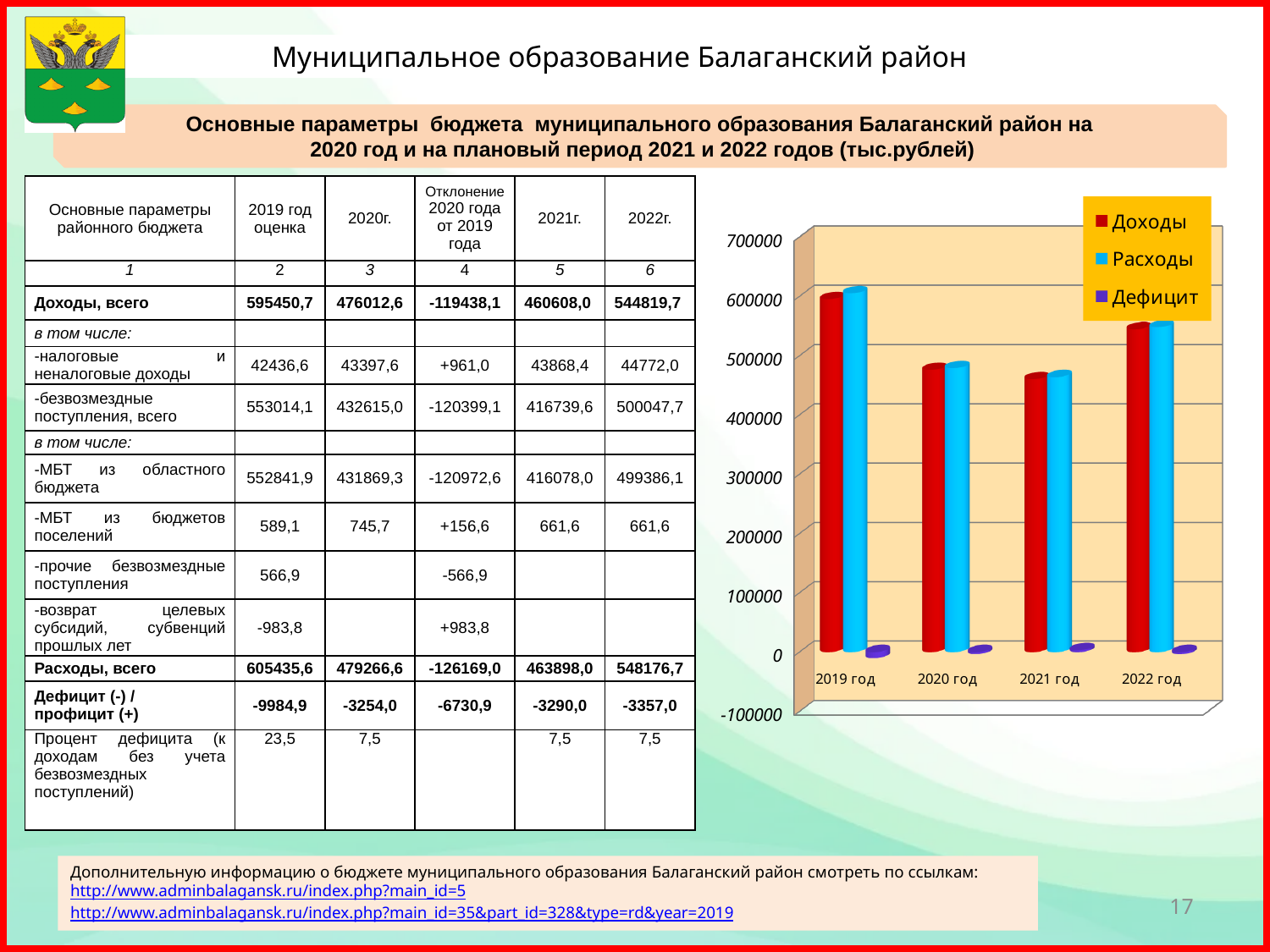
Which is larger in the chart: Доходы for 2020 год or Доходы for 2022 год? 2022 год Is the Расходы value for 2020 год greater or less than 600000? less Which year has the highest Доходы bar in the chart? 2019 год Is the Доходы value for 2021 год greater or less than 500000? less What kind of chart is shown on the right side of the slide? bar chart How many year categories are shown on the x axis of the chart? 4 Do the Доходы bars rise or fall from 2019 год to 2021 год? fall Is the Расходы value for 2022 год greater or less than 500000? greater What colour represents the Доходы series in the chart legend? red How many series does the chart legend list? 3 Which is larger in the chart: Доходы for 2019 год or Доходы for 2022 год? 2019 год